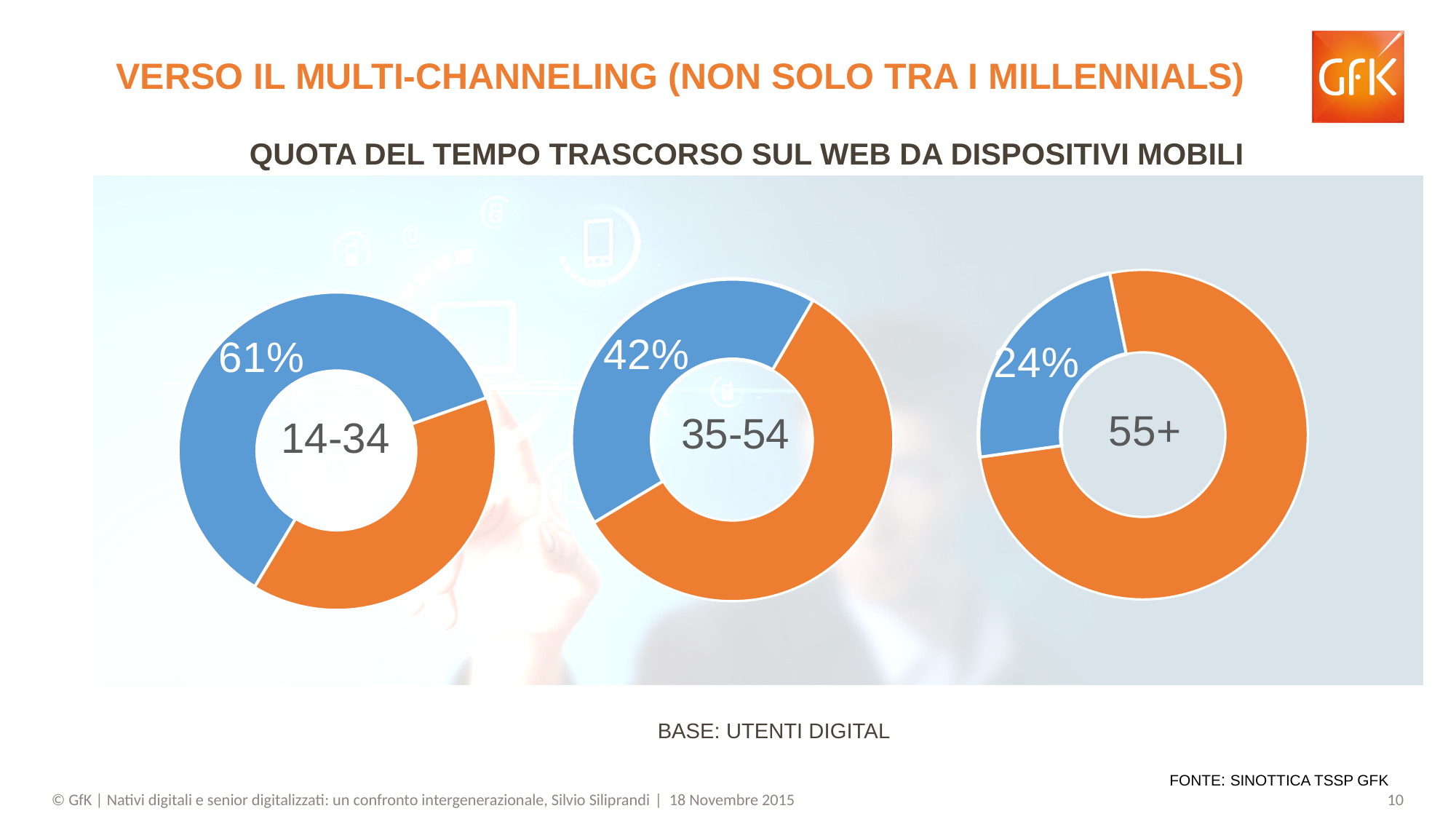
In the donut chart labelled 35-54, what percentage is shown for the blue slice? 42% What is the difference in percentage points between the 14-34 chart value and the 55+ chart value? 37 What is the title above the three donut charts? QUOTA DEL TEMPO TRASCORSO SUL WEB DA DISPOSITIVI MOBILI What kind of chart is used to show the share of time spent on the web from mobile devices? Donut chart Which is larger, the value for 35-54 or the value for 55+? 35-54 How many donut charts are shown on the slide? 3 In the donut chart labelled 55+, what percentage is shown for the blue slice? 24% What is the difference in percentage points between the 14-34 chart value and the 35-54 chart value? 19 Which age group has the lowest share of time spent on the web from mobile devices? 55+ Which age group has the highest share of time spent on the web from mobile devices? 14-34 In the donut chart labelled 14-34, what percentage is shown for the blue slice? 61% Moving from the youngest age group to the oldest, does the labelled share rise or fall? Fall